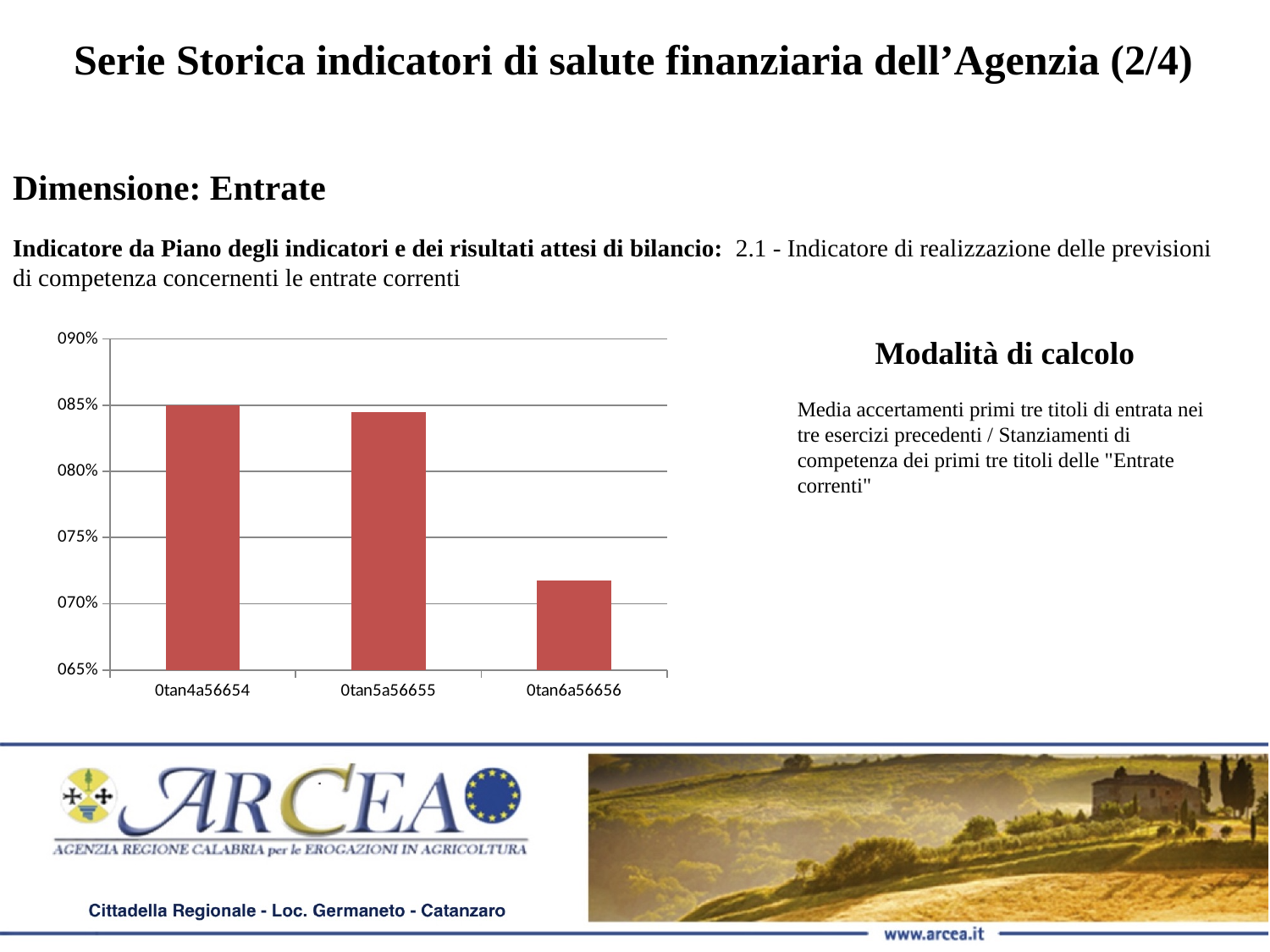
How many bars are plotted in the chart? 3 Is the value for 0tan5a56655 greater or less than 080%? greater What is the lowest value shown on the vertical axis of the chart? 065% Which category has the lowest value in the chart? 0tan6a56656 What colour are the bars in the chart? red Is the value for 0tan4a56654 greater or less than 080%? greater Do the values rise or fall from left to right across the categories? fall What kind of chart is shown on the slide? bar chart Which is larger, the value for 0tan5a56655 or the value for 0tan6a56656? 0tan5a56655 Which is larger, the value for 0tan4a56654 or the value for 0tan6a56656? 0tan4a56654 Is the value for 0tan6a56656 greater or less than 070%? greater